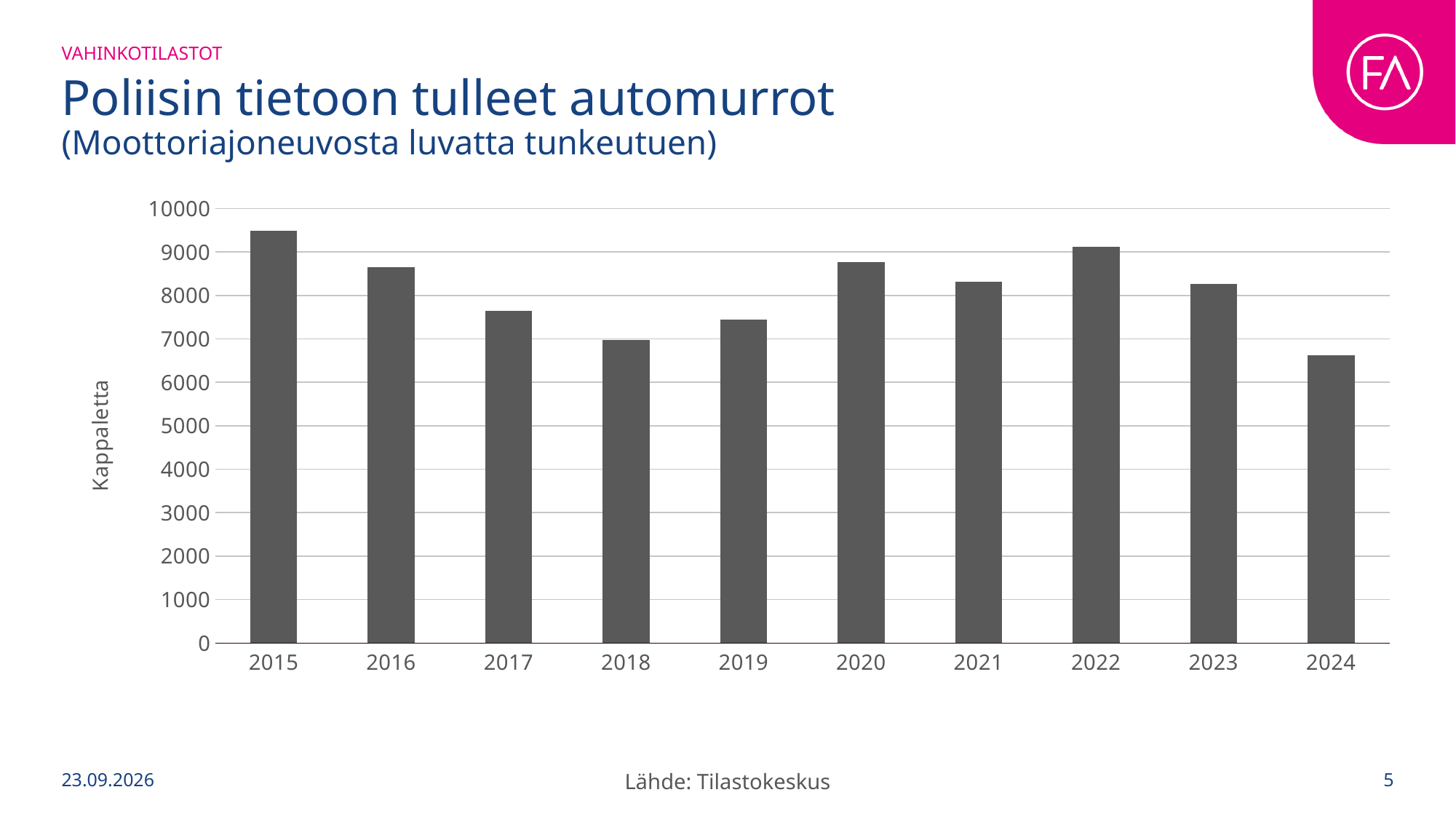
Is the value for 2015 greater or less than 9000? greater Which year has the highest bar in the chart? 2015 Is the value for 2024 greater or less than 7000? less Which year has a higher value, 2016 or 2017? 2016 Which year has a higher value, 2019 or 2020? 2020 Do the values rise or fall from 2015 to 2018? fall Which year has the lowest bar in the chart? 2024 Is the value for 2022 greater or less than 9000? greater What kind of chart is shown on the slide? bar chart What is the label on the y axis of the chart? Kappaletta How many years are shown on the x axis of the chart? 10